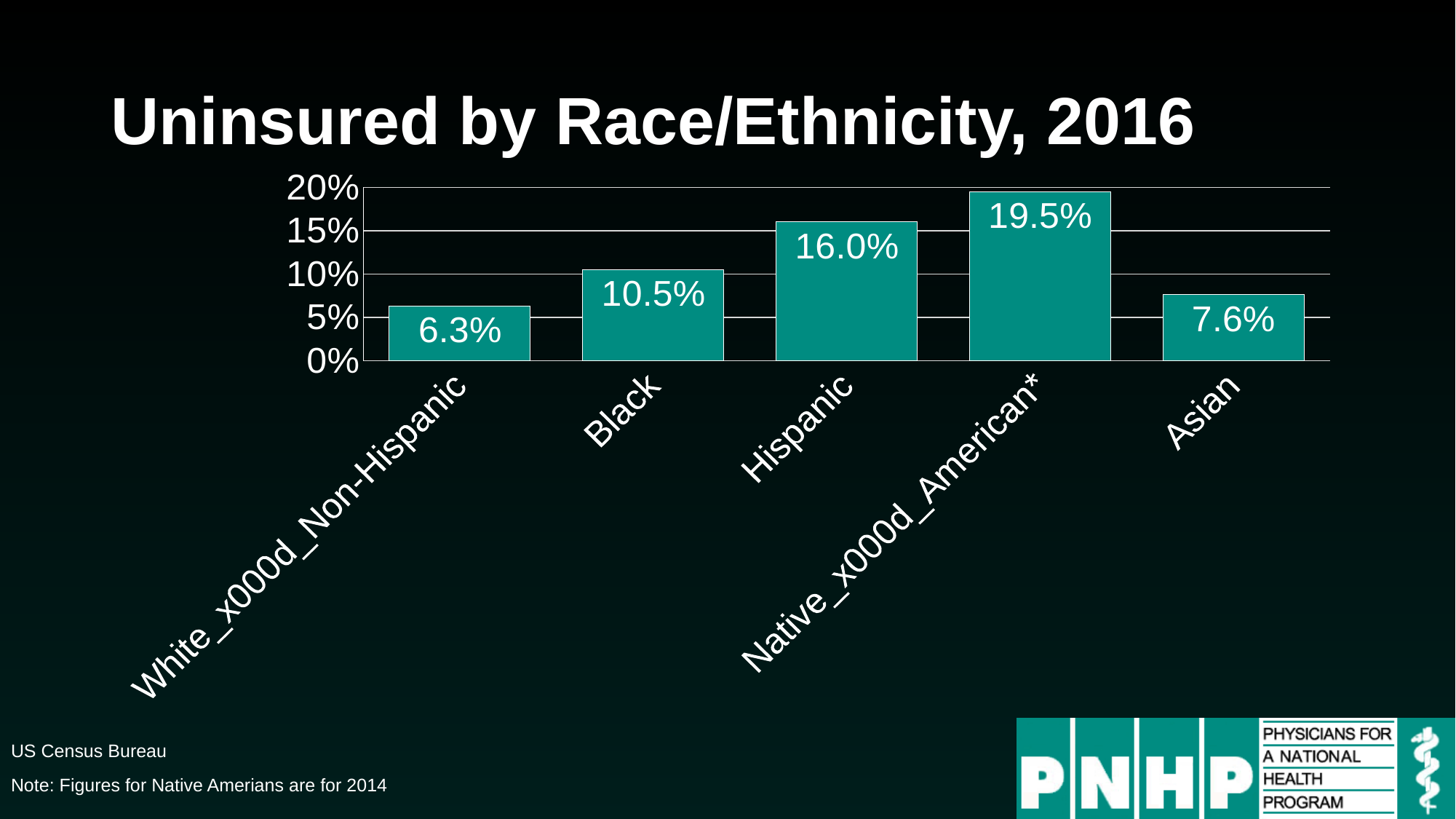
What is the difference between the uninsured rates for Native American* and White Non-Hispanic? 13.2% What is the uninsured rate for Hispanic in the chart? 16.0% Is the uninsured rate for Hispanic greater or less than 15%? greater What is the uninsured rate for Asian in the chart? 7.6% What is the uninsured rate for Black in the chart? 10.5% Which has a higher uninsured rate, Asian or Black? Black Which race/ethnicity group has the highest uninsured rate? Native American* Which race/ethnicity group has the lowest uninsured rate? White Non-Hispanic What type of chart is shown on the slide? Bar chart What is the uninsured rate for White Non-Hispanic in the chart? 6.3% How many race/ethnicity categories are shown in the chart? 5 What is the difference between the uninsured rates for Hispanic and Black? 5.5%